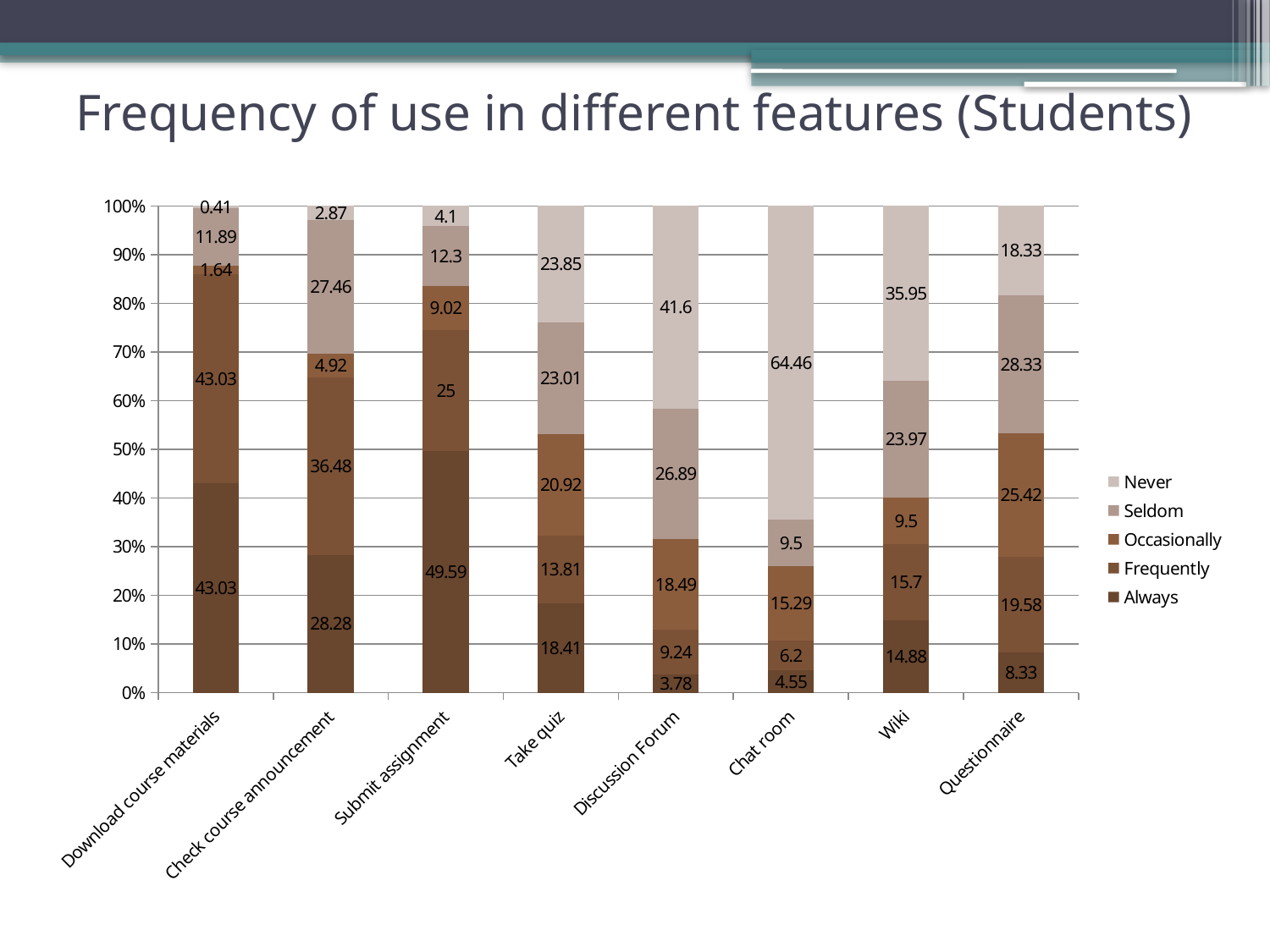
How many series does the legend list? 5 Which feature has the lowest Always value? Discussion Forum What is the title of the chart? Frequency of use in different features (Students) What kind of chart is shown on the slide? Stacked bar chart What is the Never value for Chat room? 64.46 Which feature has the highest Never value? Chat room What is the Occasionally value for Questionnaire? 25.42 What is the Always value for Submit assignment? 49.59 Which is larger, the Frequently value for Check course announcement or the Frequently value for Submit assignment? Check course announcement What is the Seldom value for Wiki? 23.97 What is the difference between the Never values for Discussion Forum and Take quiz? 17.75 How many features are shown on the x axis? 8